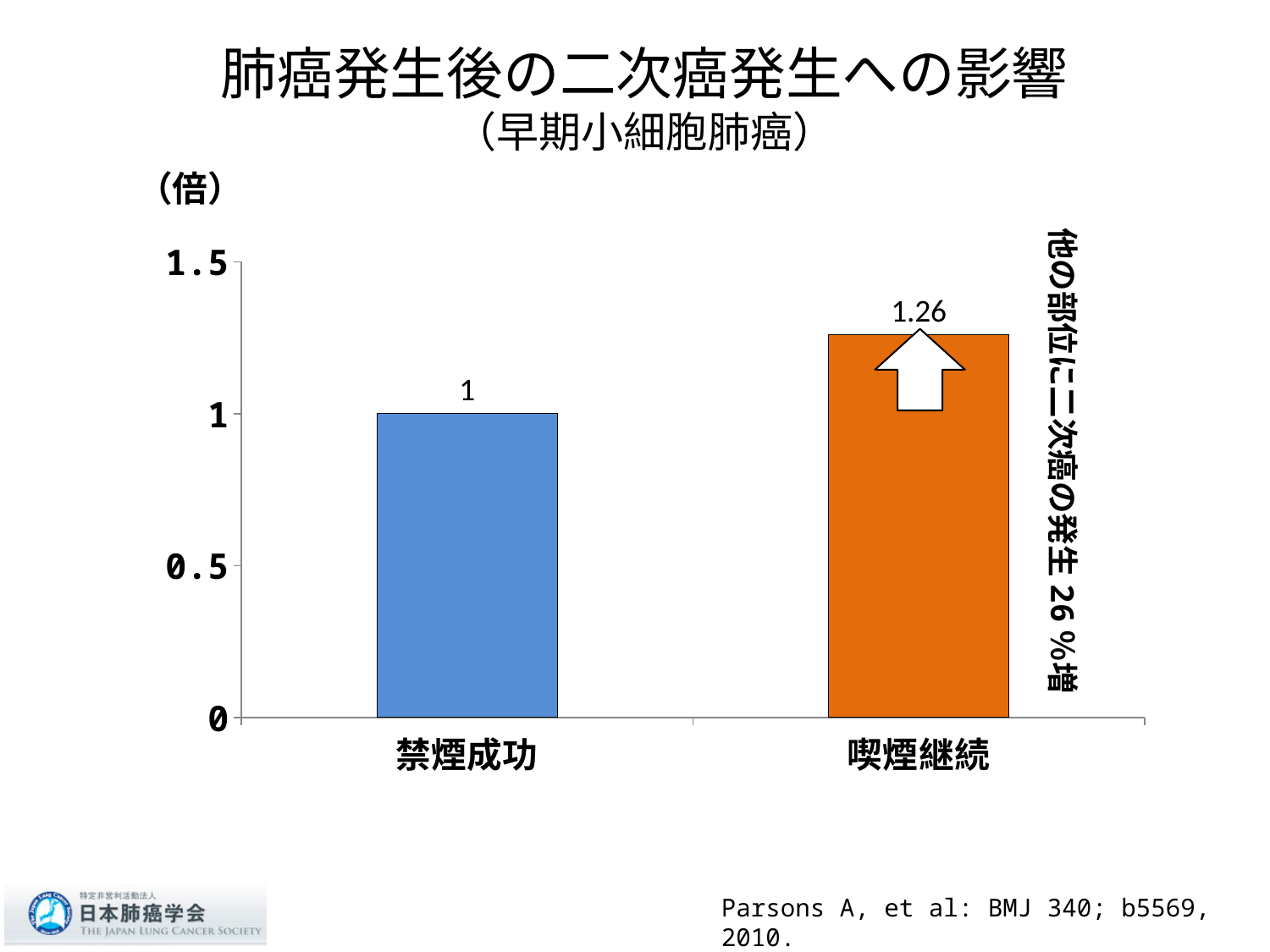
What is the value for 禁煙成功? 1 Is the value for 喫煙継続 greater or less than 1.5? less Which category has the lowest value? 禁煙成功 Which is larger, the value for 禁煙成功 or the value for 喫煙継続? 喫煙継続 How many categories are shown on the x axis? 2 What unit is shown at the top of the y axis? 倍 What colour is the bar for 喫煙継続? orange What is the value for 喫煙継続? 1.26 What kind of chart is shown on the slide? bar chart Which category has the highest value? 喫煙継続 What is the difference between the values for 喫煙継続 and 禁煙成功? 0.26